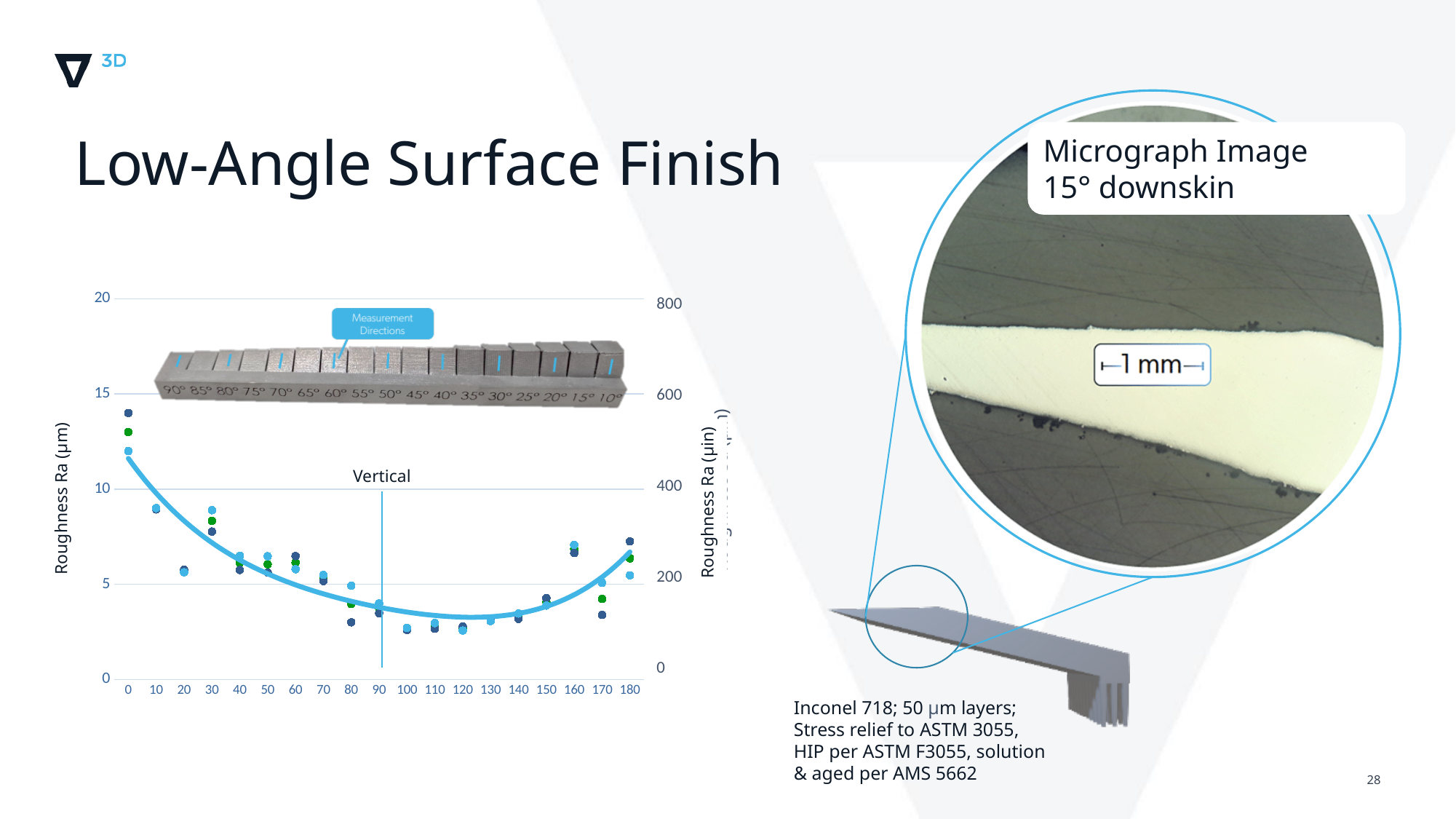
Is the roughness value at x = 0 greater or less than 10 µm on the left axis? greater How many tick labels are shown on the x axis of the chart? 19 Is the roughness value at x = 90 greater or less than 5 µm on the left axis? less Which x-axis position has the highest roughness values in the chart? 0 Is the roughness value at x = 30 greater or less than 10 µm on the left axis? less Do the roughness values rise or fall as x increases from 0 to 90? fall What is the label of the right vertical axis of the chart? Roughness Ra (µin) What kind of chart is shown on the left of the slide? scatter chart Do the roughness values rise or fall as x increases from 90 to 180? rise What is the label of the left vertical axis of the chart? Roughness Ra (µm)